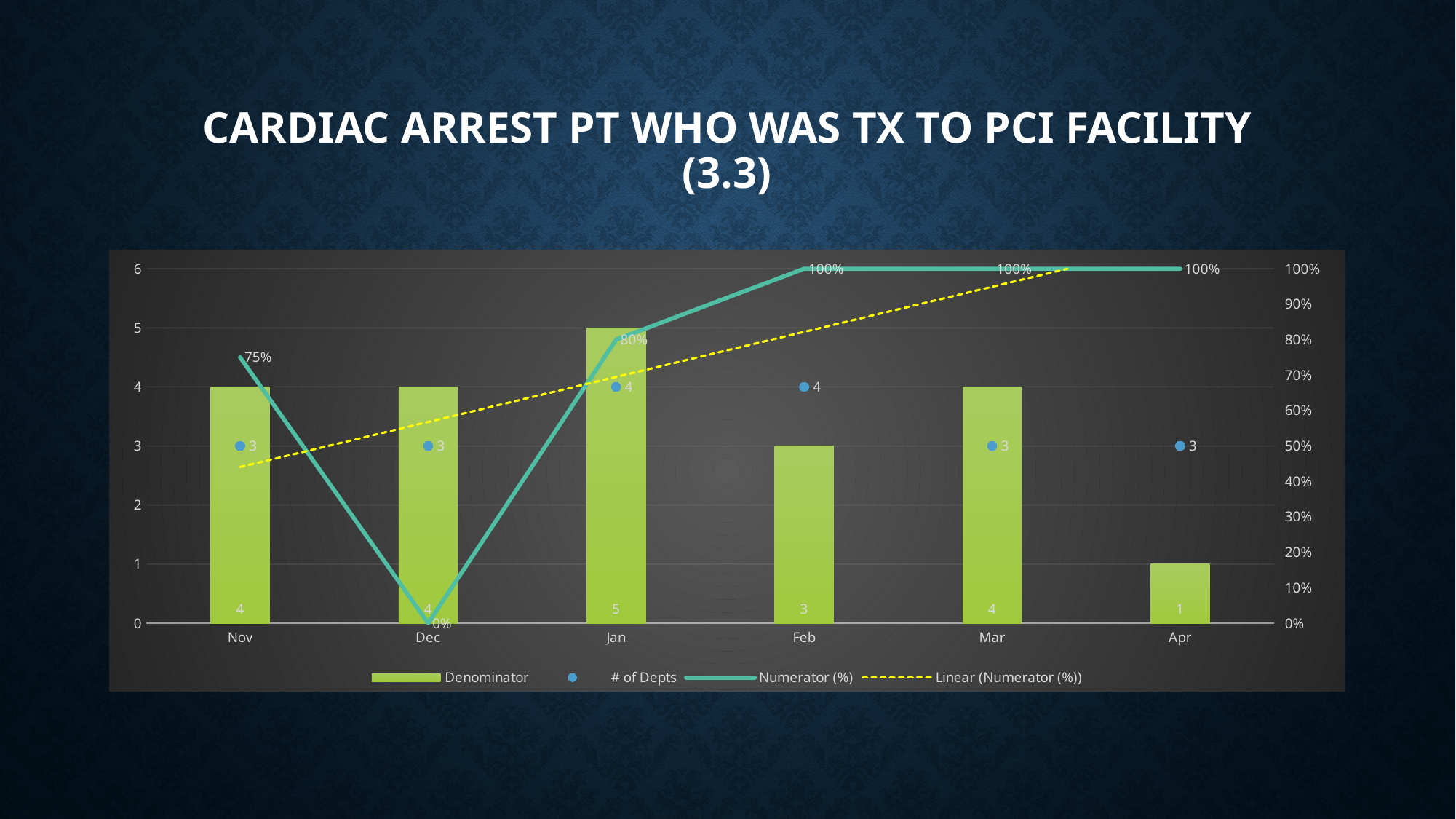
Which month has the highest Denominator value? Jan Which month has the lowest Denominator value? Apr Does the Numerator (%) line rise or fall from Dec to Feb? Rise What is the Denominator value for Jan? 5 What is the Numerator (%) value for Dec? 0% What is the difference between the Denominator values for Jan and Apr? 4 Which is larger, the Numerator (%) for Jan or for Nov? Jan How many series does the legend list? 4 What is the Numerator (%) value for Nov? 75% How many months are shown on the x axis? 6 What is the # of Depts value for Feb? 4 What kind of chart is used for the Denominator series? Bar chart